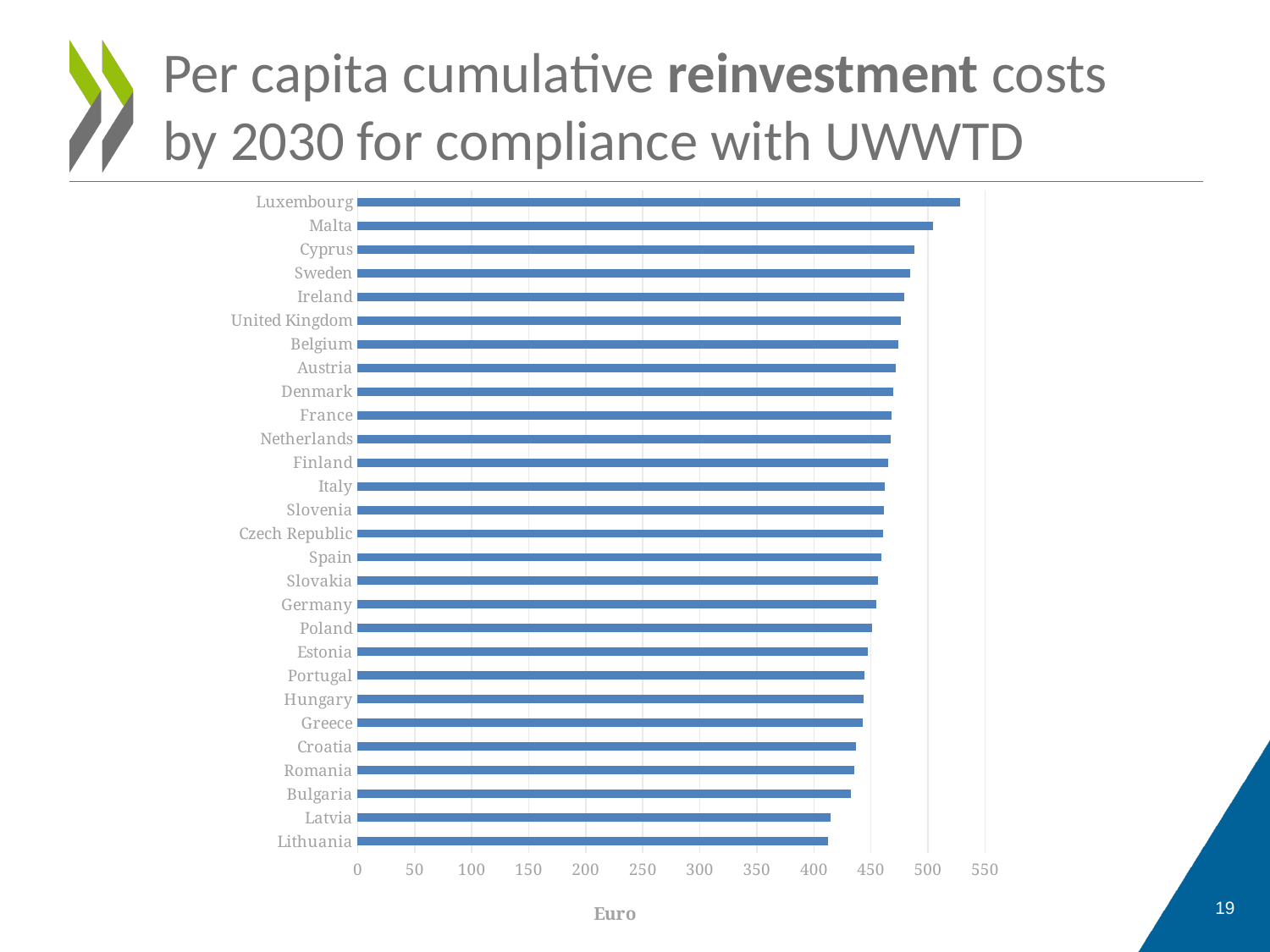
Is the value for Lithuania greater or less than 450? less Is the value for Bulgaria greater or less than 450? less What kind of chart is shown on the slide? Bar chart Which has a larger value, Latvia or Germany? Germany How many countries are shown in the chart? 28 Is the value for Sweden greater or less than 500? less What is the title of the horizontal axis? Euro Do the bar values increase or decrease going from the top of the chart to the bottom? decrease Which has a larger value, Luxembourg or Malta? Luxembourg Which country has the highest per capita cumulative reinvestment cost? Luxembourg